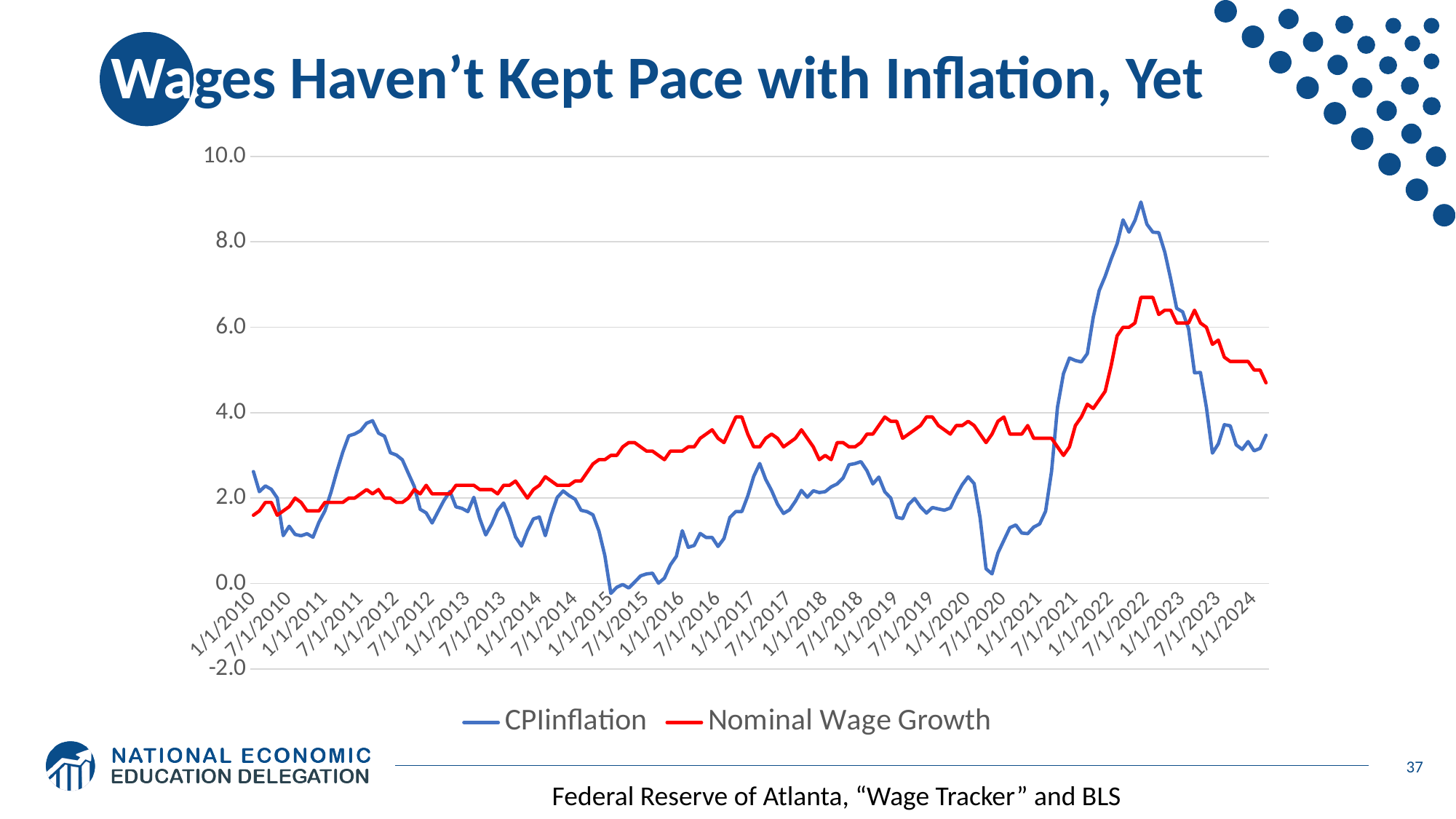
What kind of chart is shown on the slide? Line chart Is the peak value of Nominal Wage Growth (around 7/1/2022) greater or less than 6.0? greater What is the title of the chart slide? Wages Haven't Kept Pace with Inflation, Yet Is the peak value of CPI inflation (around 7/1/2022) greater or less than 8.0? greater Is the value of Nominal Wage Growth at 1/1/2024 greater or less than 4.0? greater Does CPI inflation rise or fall between 7/1/2022 and 7/1/2023? Fall What are the two series named in the legend? CPIinflation and Nominal Wage Growth How many series does the legend list? 2 At 1/1/2022, which series is higher, CPI inflation or Nominal Wage Growth? CPI inflation At 1/1/2016, which series is higher, CPI inflation or Nominal Wage Growth? Nominal Wage Growth